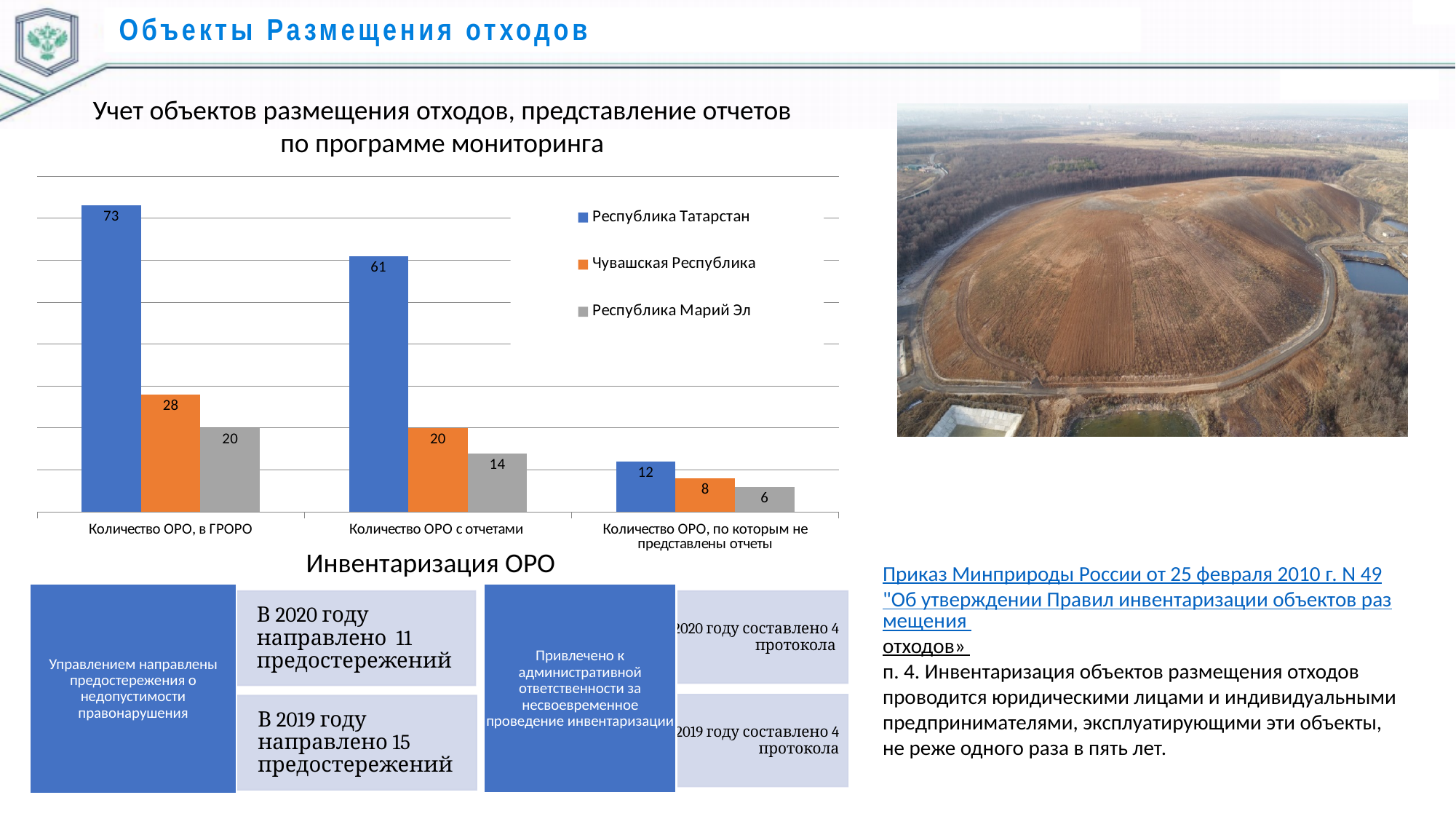
How many categories are shown on the x axis of the chart? 3 Which is larger: the value for Чувашская Республика or Республика Марий Эл in the category 'Количество ОРО, по которым не представлены отчеты'? Чувашская Республика What is the value for Республика Татарстан in the category 'Количество ОРО, в ГРОРО'? 73 What colour represents Чувашская Республика in the chart? Orange What is the difference between the values for Республика Татарстан and Чувашская Республика in the category 'Количество ОРО, в ГРОРО'? 45 How many series does the chart legend list? 3 Which region has the lowest value in the category 'Количество ОРО, в ГРОРО'? Республика Марий Эл Do the values for Республика Татарстан rise or fall across the categories from left to right? Fall What is the value for Республика Марий Эл in the category 'Количество ОРО, по которым не представлены отчеты'? 6 What kind of chart is shown on the slide? Bar chart What is the value for Чувашская Республика in the category 'Количество ОРО с отчетами'? 20 Which region has the highest value in the category 'Количество ОРО с отчетами'? Республика Татарстан